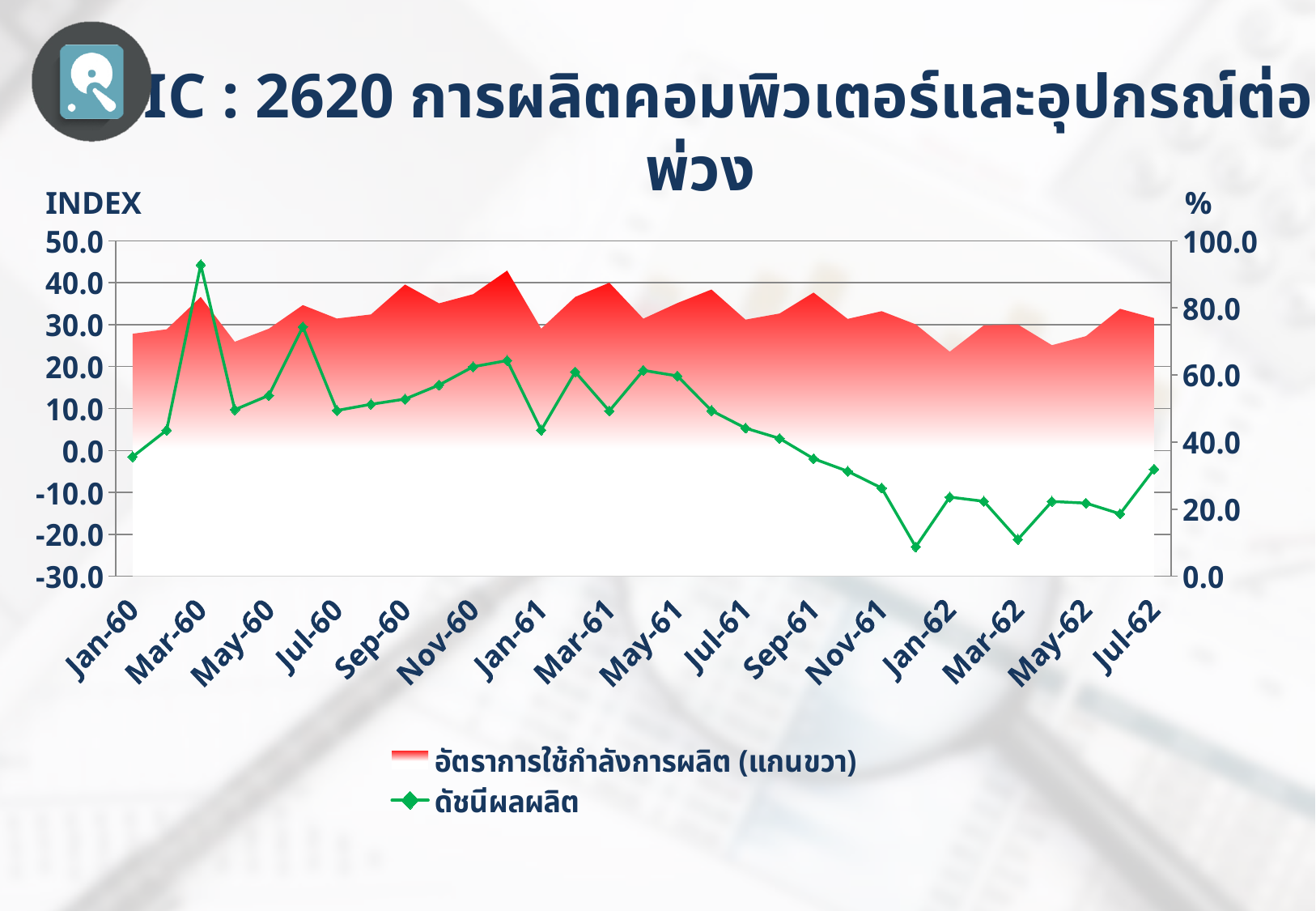
What is the label of the left vertical axis? INDEX What kind of chart is shown on the slide? A combined area and line chart Is the value of the green line (ดัชนีผลผลิต) at Jan-60 greater or less than 10.0 on the left axis? less Which series is plotted against the right axis according to the legend? อัตราการใช้กำลังการผลิต (แกนขวา) Does the green line (ดัชนีผลผลิต) rise or fall from May-61 to Jan-62? Fall Is the value of the green line (ดัชนีผลผลิต) at Mar-60 greater or less than 40.0 on the left axis? greater Is the red area (อัตราการใช้กำลังการผลิต) at Jan-60 greater or less than 60.0 on the right axis? greater How many series does the legend list? 2 How many month labels are shown along the x axis? 16 At which month does the green line (ดัชนีผลผลิต) reach its highest value? Mar-60 Which is larger for the green line (ดัชนีผลผลิต): the value at Mar-60 or the value at Jul-60? Mar-60